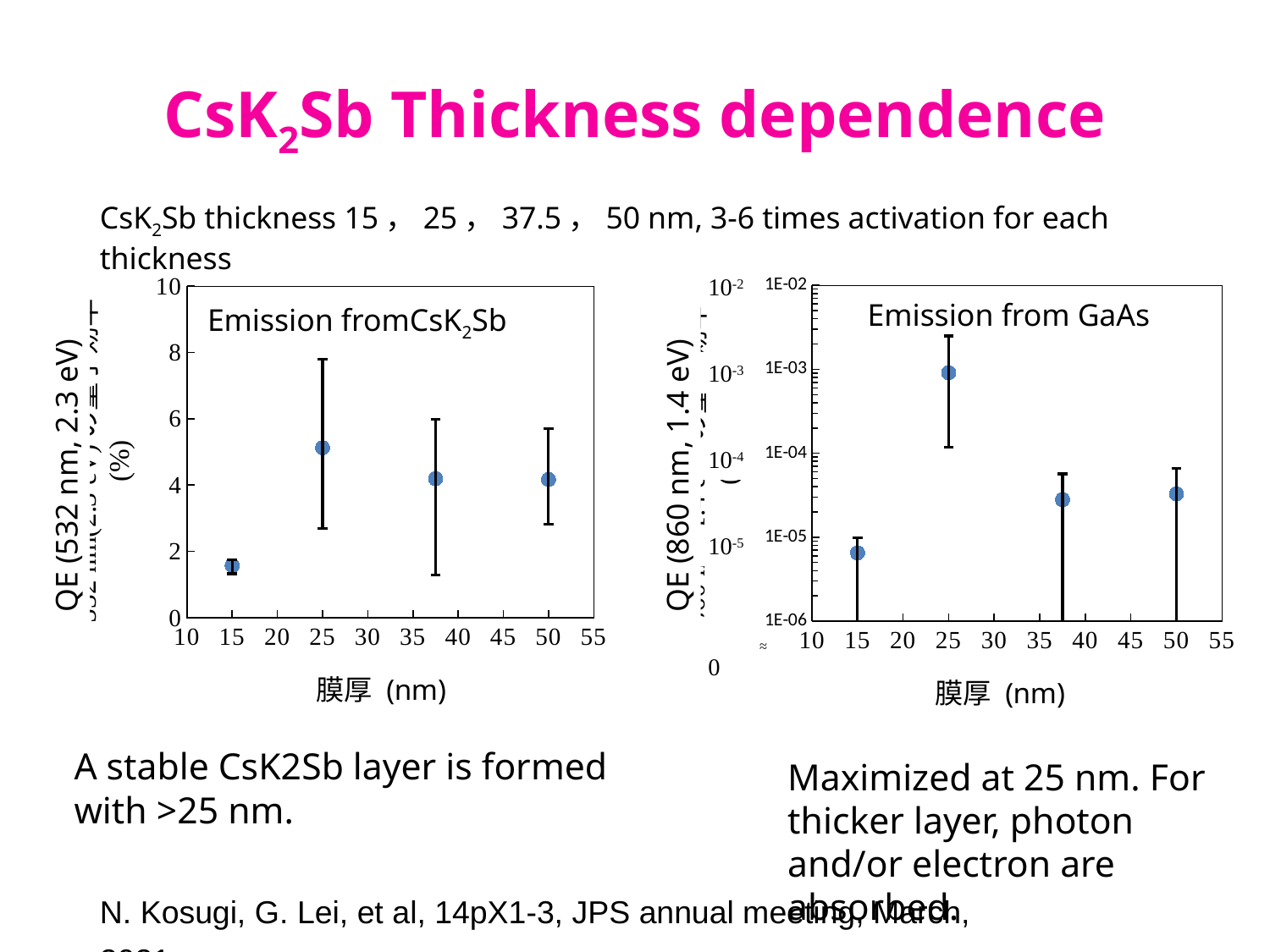
In the left chart 'Emission from CsK2Sb', how many data points are plotted? 4 In the right chart 'Emission from GaAs', at which thickness is the QE highest? 25 nm In the left chart 'Emission from CsK2Sb', is the QE value at 25 nm greater or less than 4? greater In the left chart 'Emission from CsK2Sb', which thickness has the larger QE, 15 nm or 25 nm? 25 nm In the right chart 'Emission from GaAs', is the QE value at 25 nm greater or less than 1E-04? greater In the right chart 'Emission from GaAs', at which thickness is the QE lowest? 15 nm In the left chart 'Emission from CsK2Sb', at which thickness is the QE highest? 25 nm In the left chart 'Emission from CsK2Sb', at which thickness is the QE lowest? 15 nm In the right chart 'Emission from GaAs', is the QE value at 15 nm greater or less than 1E-05? less What is the title shown inside the right chart? Emission from GaAs What kind of chart is the left chart titled 'Emission from CsK2Sb'? scatter chart